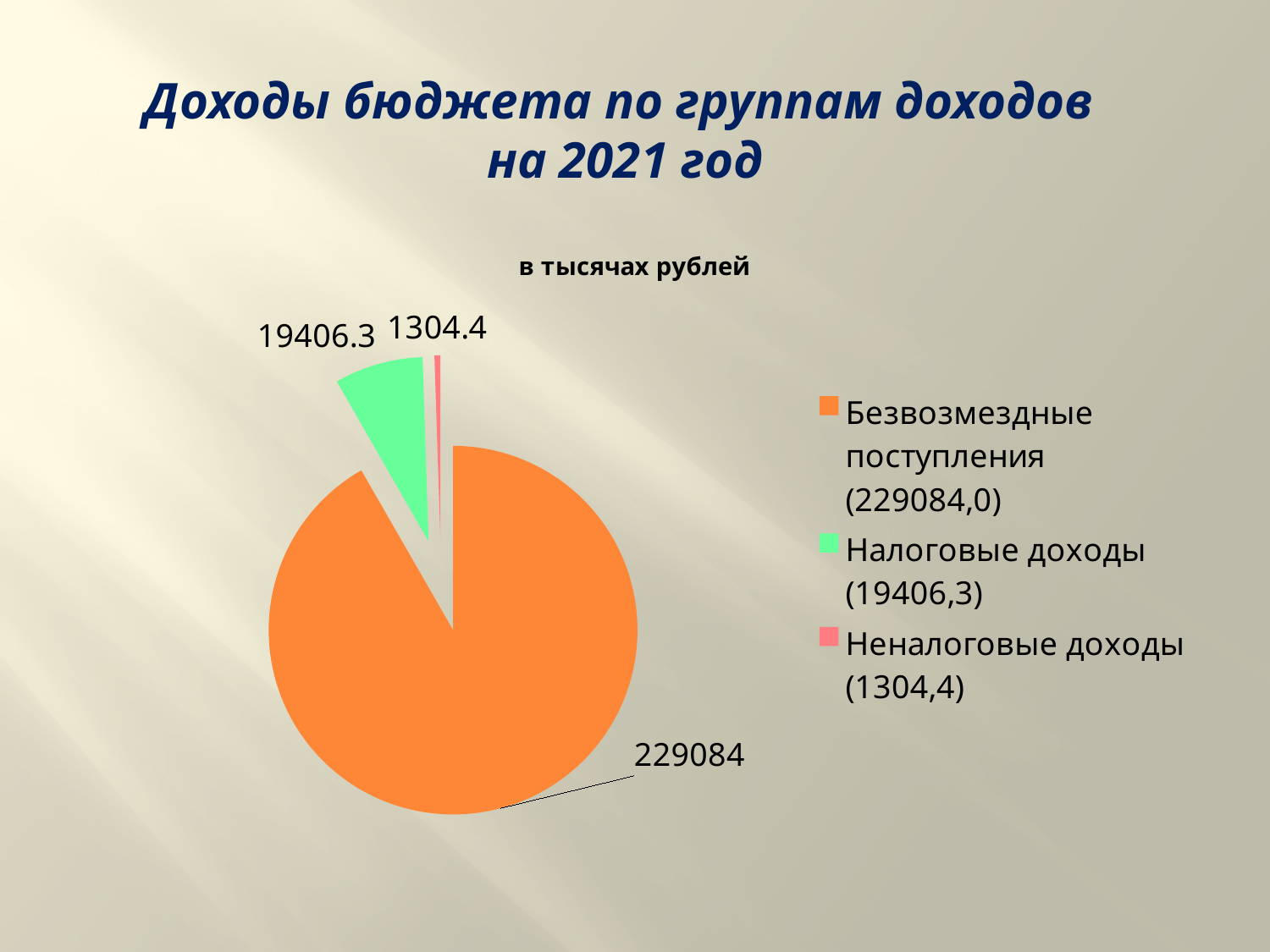
What is the value for Неналоговые доходы? 1304.4 What is the value for Налоговые доходы? 19406.3 What is the difference between Налоговые доходы and Неналоговые доходы? 18101.9 Which category has the largest slice of the pie? Безвозмездные поступления How many categories does the pie chart have? 3 What type of chart is shown on the slide? pie chart What is the difference between Безвозмездные поступления and Налоговые доходы? 209677.7 What is the value for Безвозмездные поступления? 229084 Which is larger, Налоговые доходы or Неналоговые доходы? Налоговые доходы What unit is stated in the chart title above the pie? в тысячах рублей What is the total of all three slices of the pie? 249794.7 Which category has the smallest slice of the pie? Неналоговые доходы